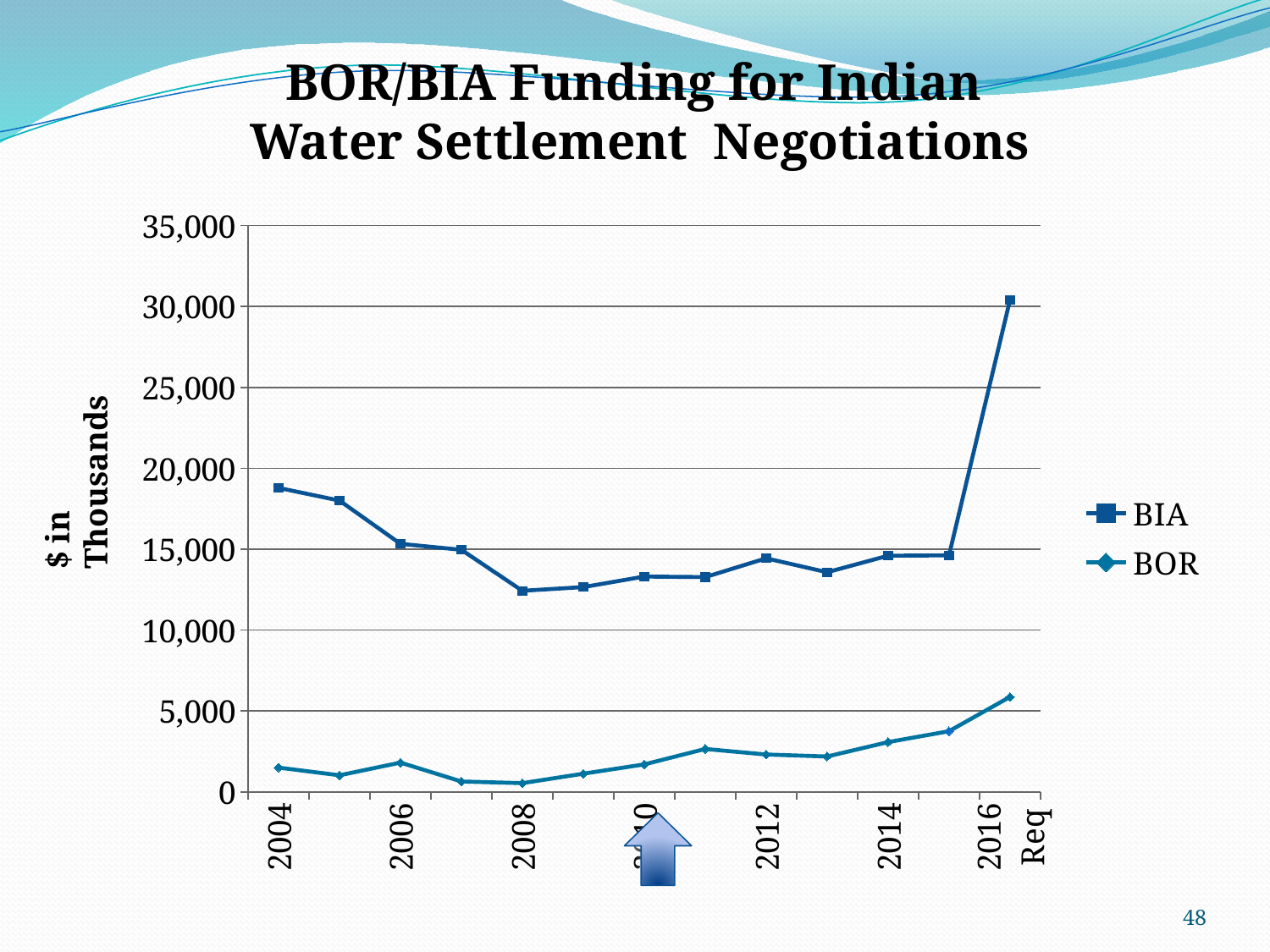
Is the BOR value for 2016 Req greater or less than 5,000? greater Is the BIA value for 2016 Req greater or less than 25,000? greater Is the BIA value for 2004 greater or less than 15,000? greater What is the label on the vertical axis? $ in Thousands What kind of chart is shown on the slide? line chart In which year does the BIA series reach its highest value? 2016 Req Which series reaches the highest value on the chart? BIA In which year does the BOR series reach its highest value? 2016 Req How many series does the legend list? 2 In which year does the BIA series reach its lowest value? 2008 Which series has the larger value in 2012, BIA or BOR? BIA